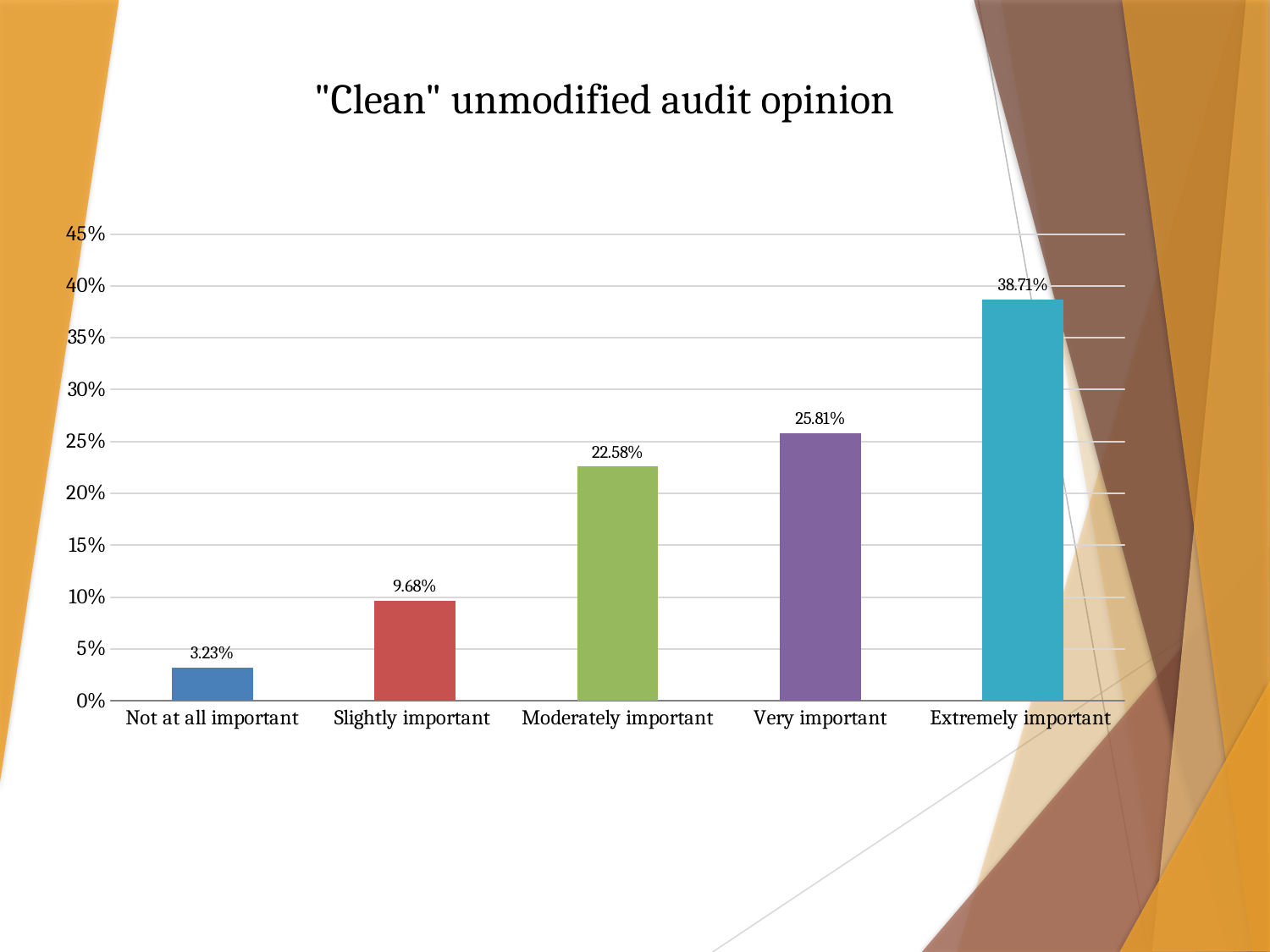
What is the title of the chart? "Clean" unmodified audit opinion Which category has the highest value? Extremely important Is the value for "Not at all important" greater or less than 5%? less What is the value for "Extremely important"? 38.71% What is the difference between the values for "Extremely important" and "Very important"? 12.90% Which is larger, the value for "Very important" or the value for "Moderately important"? Very important Which category has the lowest value? Not at all important What is the value for "Slightly important"? 9.68% How many categories are shown on the x axis? 5 What kind of chart is shown on the slide? Bar chart What is the value for "Moderately important"? 22.58% Do the values rise or fall from left to right along the x axis? Rise